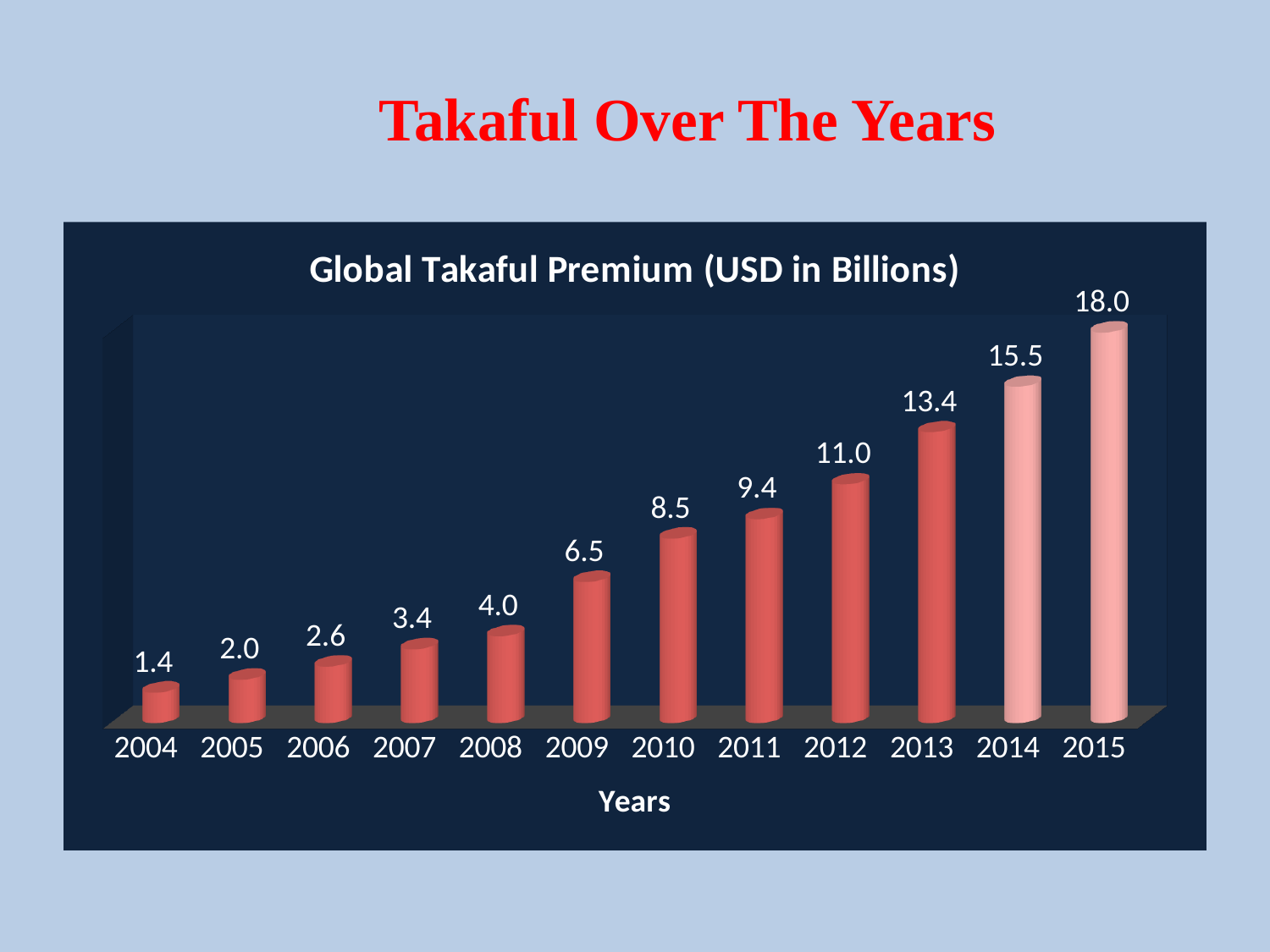
What is the difference between the global Takaful premium in 2015 and in 2014? 2.5 What is the title of the chart? Global Takaful Premium (USD in Billions) What is the global Takaful premium for 2009? 6.5 How many years are shown on the chart? 12 What is the difference between the global Takaful premium in 2010 and in 2008? 4.5 Do the global Takaful premium values rise or fall from 2004 to 2015? Rise What is the global Takaful premium for 2013? 13.4 What is the global Takaful premium for 2004? 1.4 Which year has a larger global Takaful premium, 2011 or 2012? 2012 Which year has the lowest global Takaful premium? 2004 What kind of chart is shown on the slide? Bar chart Which year has the highest global Takaful premium? 2015